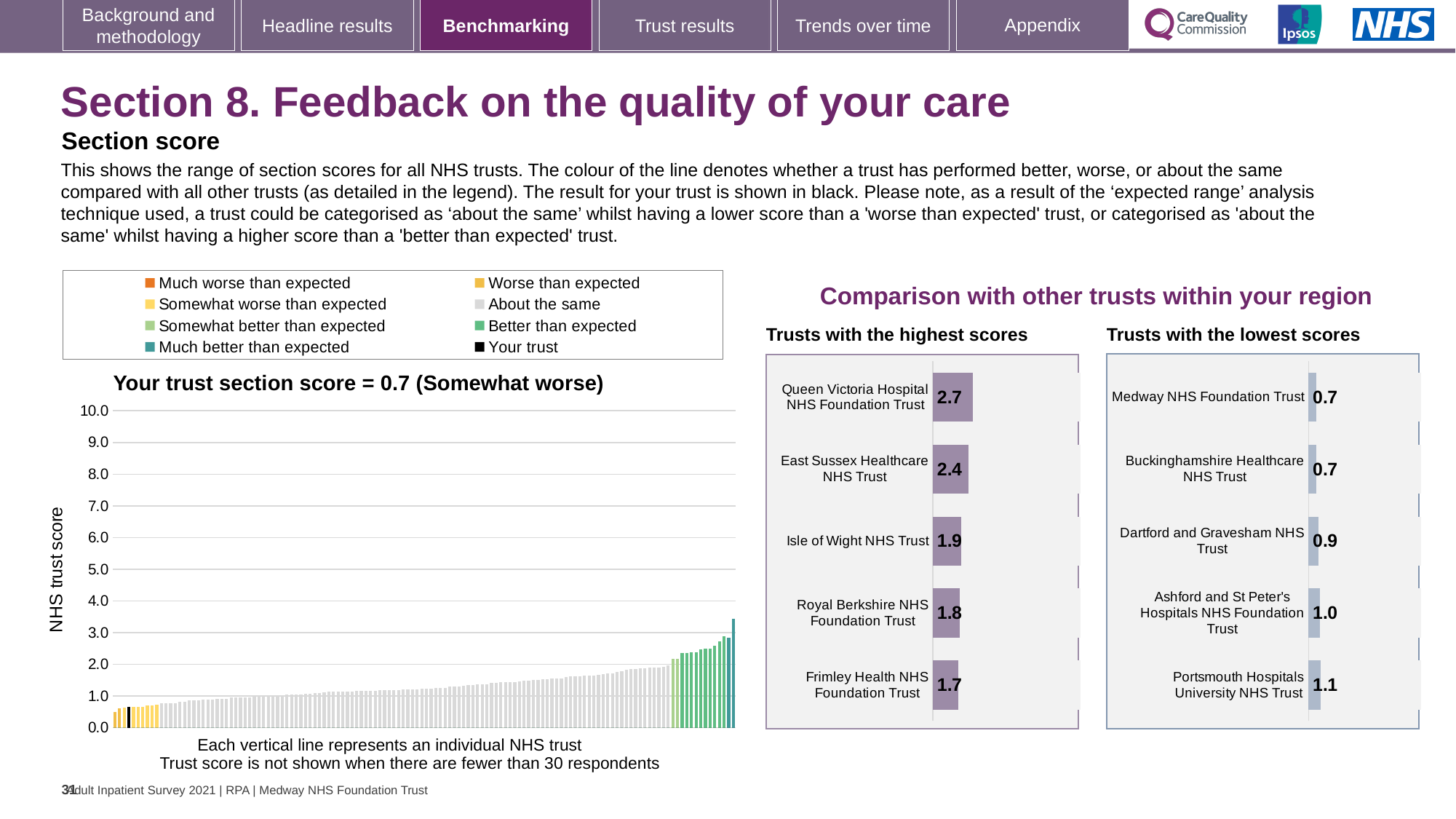
How many entries does the legend above the 'Your trust section score' chart list? 8 In the 'Your trust section score' chart, do the bar values rise or fall from left to right? rise How many trusts are shown in the 'Trusts with the lowest scores' chart? 5 In the 'Your trust section score' chart, is the value of the tallest bar greater or less than 3.0? greater In the 'Trusts with the highest scores' chart, what is the difference between the scores of Queen Victoria Hospital NHS Foundation Trust and Frimley Health NHS Foundation Trust? 1.0 In the 'Trusts with the highest scores' chart, which trust has the lowest score? Frimley Health NHS Foundation Trust In the 'Your trust section score' chart, what is the section score for your trust? 0.7 In the 'Trusts with the highest scores' chart, what is the score for Isle of Wight NHS Trust? 1.9 In the 'Trusts with the lowest scores' chart, which has the larger score: Ashford and St Peter's Hospitals NHS Foundation Trust or Medway NHS Foundation Trust? Ashford and St Peter's Hospitals NHS Foundation Trust In the 'Trusts with the highest scores' chart, what is the score for Queen Victoria Hospital NHS Foundation Trust? 2.7 In the 'Trusts with the lowest scores' chart, what is the score for Dartford and Gravesham NHS Trust? 0.9 In the 'Trusts with the lowest scores' chart, which trust has the highest score? Portsmouth Hospitals University NHS Trust